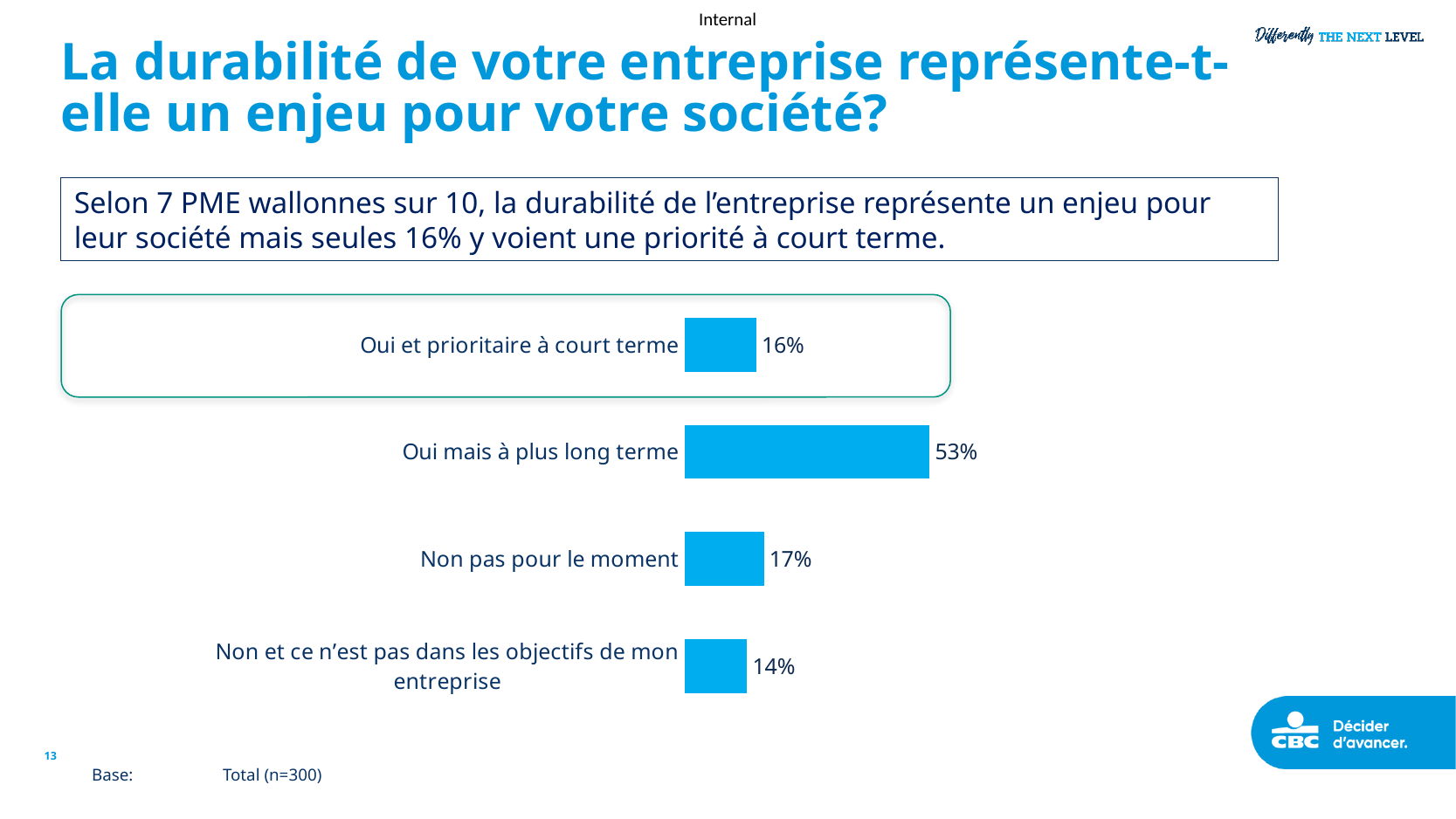
What is the value for "Non et ce n'est pas dans les objectifs de mon entreprise"? 14% How many categories are shown in the chart? 4 Which is larger: "Non pas pour le moment" or "Oui et prioritaire à court terme"? Non pas pour le moment What is the value for "Oui mais à plus long terme"? 53% What is the value for "Oui et prioritaire à court terme"? 16% What is the base (sample size) stated for the chart? Total (n=300) What is the value for "Non pas pour le moment"? 17% What kind of chart is shown on the slide? Bar chart What is the difference between "Oui mais à plus long terme" and "Oui et prioritaire à court terme"? 37% What is the difference between "Non pas pour le moment" and "Non et ce n'est pas dans les objectifs de mon entreprise"? 3% Which category has the lowest value? Non et ce n'est pas dans les objectifs de mon entreprise Which category has the highest value? Oui mais à plus long terme